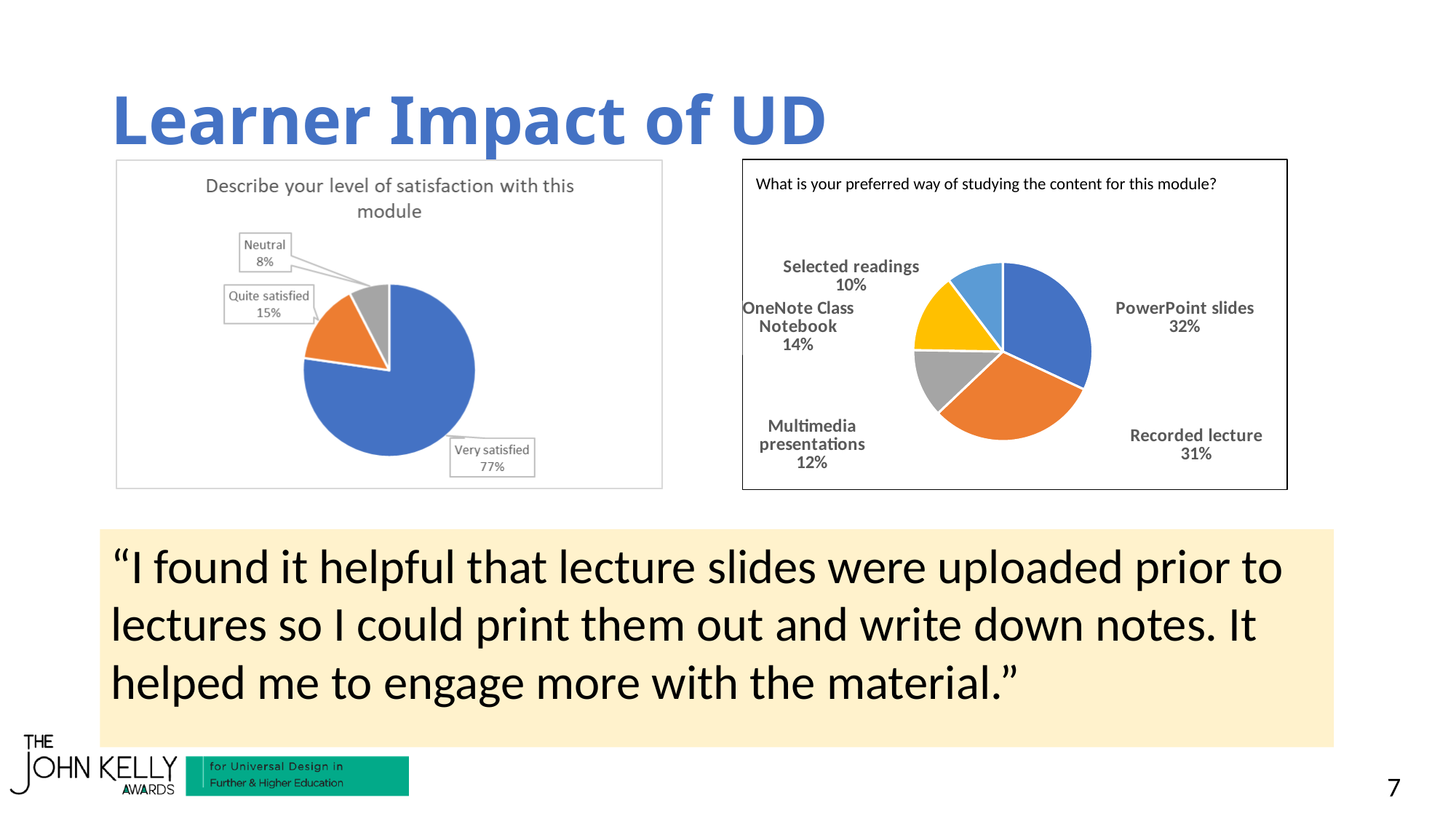
In the chart titled "What is your preferred way of studying the content for this module?", which option has the smallest share? Selected readings In the chart titled "What is your preferred way of studying the content for this module?", what share chose Recorded lecture? 31% In the chart titled "Describe your level of satisfaction with this module", what percentage of respondents were Very satisfied? 77% What kind of chart is the one titled "What is your preferred way of studying the content for this module?"? Pie chart In the chart titled "What is your preferred way of studying the content for this module?", which is larger: Multimedia presentations or OneNote Class Notebook? OneNote Class Notebook In the chart titled "What is your preferred way of studying the content for this module?", how many options are shown? 5 In the chart titled "Describe your level of satisfaction with this module", which category has the smallest share? Neutral In the chart titled "Describe your level of satisfaction with this module", what percentage of respondents were Quite satisfied? 15% In the chart titled "What is your preferred way of studying the content for this module?", what share chose OneNote Class Notebook? 14% In the chart titled "What is your preferred way of studying the content for this module?", which option has the largest share? PowerPoint slides In the chart titled "Describe your level of satisfaction with this module", what is the difference between the Very satisfied and Quite satisfied shares? 62% In the chart titled "Describe your level of satisfaction with this module", how many categories are shown? 3